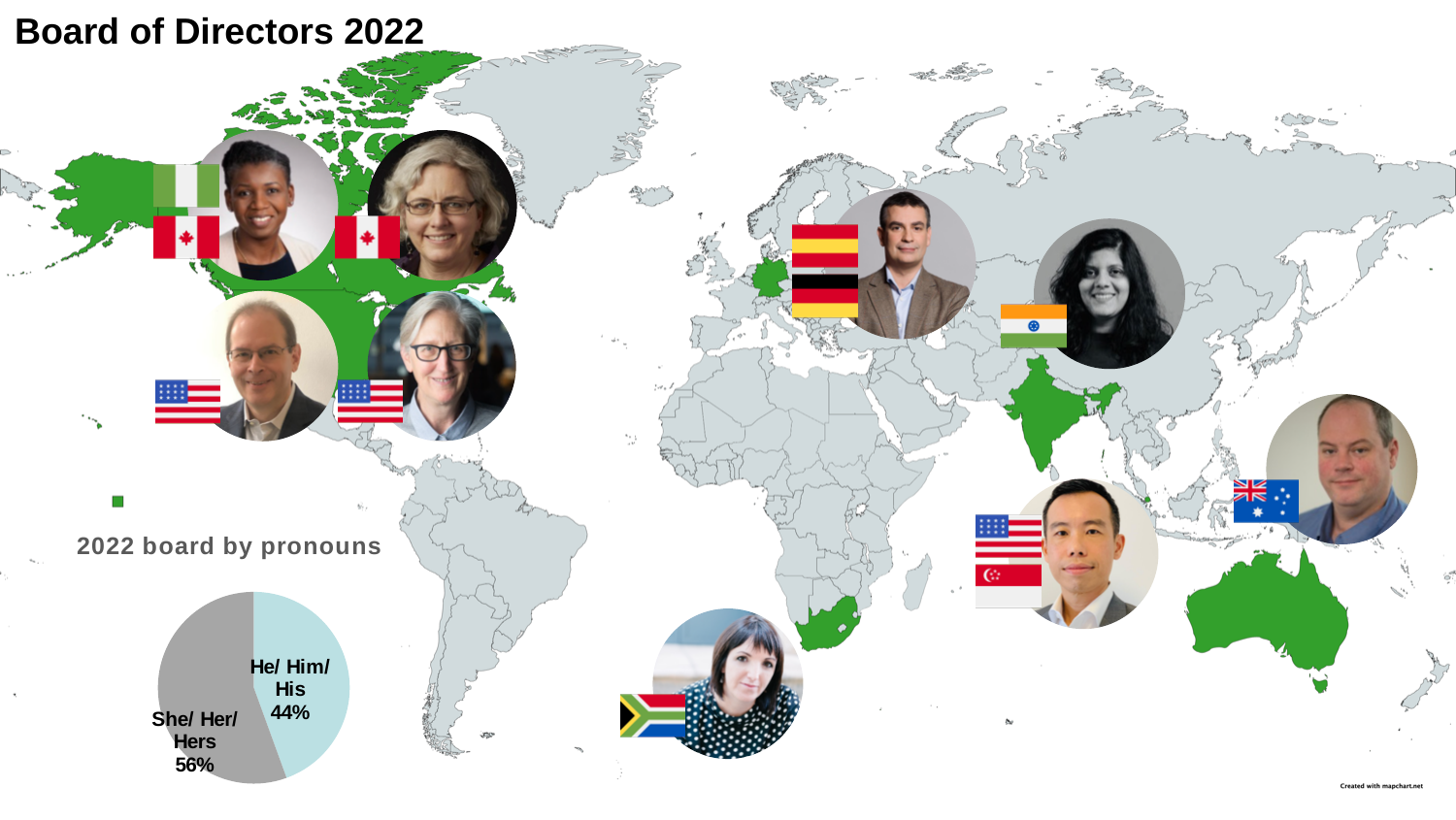
What kind of chart is shown under the heading "2022 board by pronouns"? pie chart In the "2022 board by pronouns" pie chart, is the He/ Him/ His share greater or less than 50%? less In the "2022 board by pronouns" pie chart, what colour is the He/ Him/ His slice? light blue How many slices does the "2022 board by pronouns" pie chart have? 2 In the "2022 board by pronouns" pie chart, what is the difference in percentage points between the She/ Her/ Hers and He/ Him/ His slices? 12 What is the title of the pie chart on the slide? 2022 board by pronouns In the "2022 board by pronouns" pie chart, what share is labelled He/ Him/ His? 44% In the "2022 board by pronouns" pie chart, what share is labelled She/ Her/ Hers? 56% Which slice of the "2022 board by pronouns" pie chart is the largest? She/ Her/ Hers In the "2022 board by pronouns" pie chart, which is larger: He/ Him/ His or She/ Her/ Hers? She/ Her/ Hers Which slice of the "2022 board by pronouns" pie chart is the smallest? He/ Him/ His